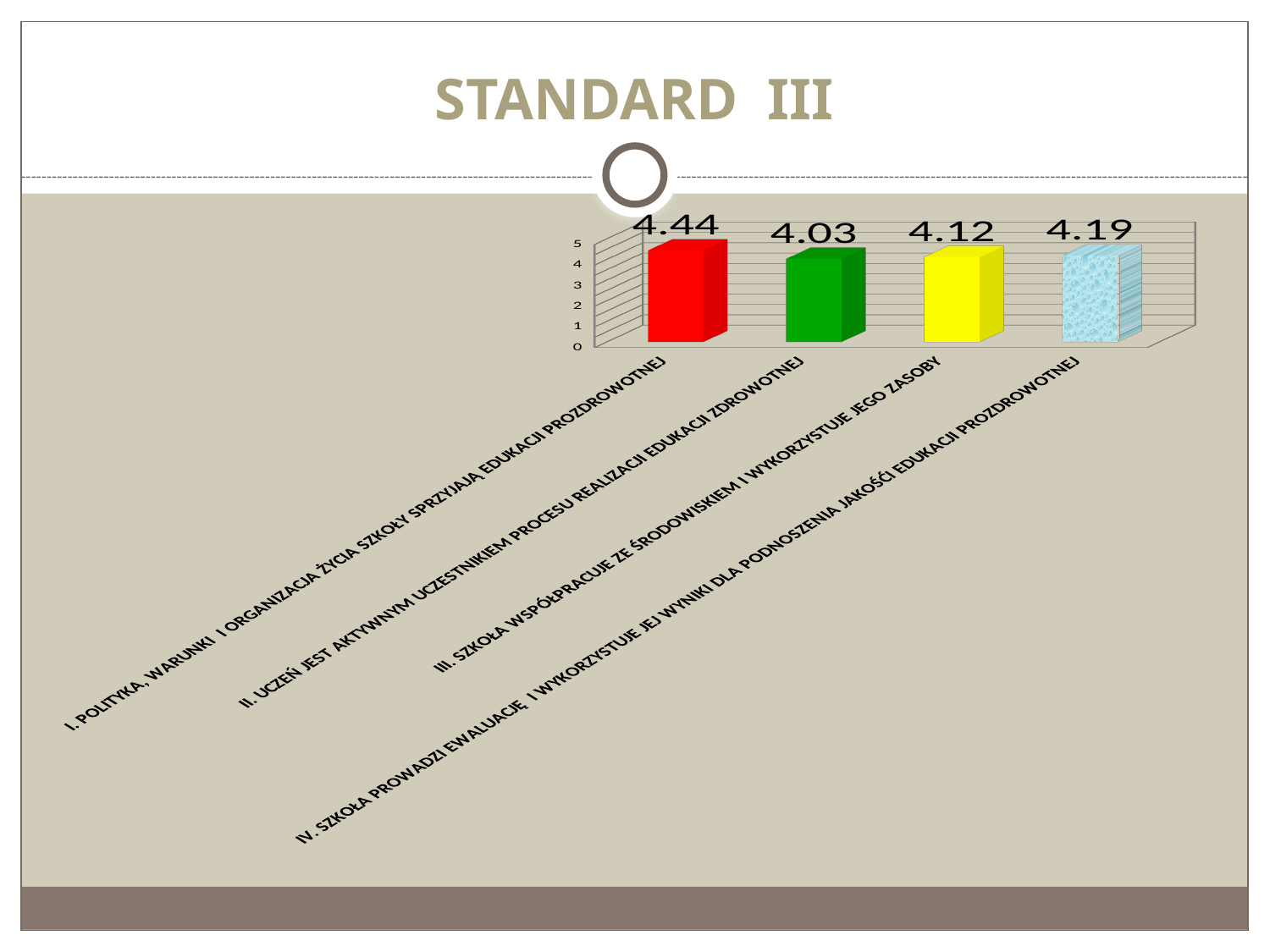
What is the value for category III (SZKOŁA WSPÓŁPRACUJE ZE ŚRODOWISKIEM I WYKORZYSTUJE JEGO ZASOBY)? 4.12 How many categories are shown in the chart? 4 What kind of chart is shown on the slide? bar chart What is the difference between the values for category IV and category III? 0.07 What is the difference between the values for category I and category II? 0.41 What is the value for category I (POLITYKA, WARUNKI I ORGANIZACJA ŻYCIA SZKOŁY SPRZYJAJĄ EDUKACJI PROZDROWOTNEJ)? 4.44 Which is larger, the value for category III or the value for category IV? category IV What is the value for category IV (SZKOŁA PROWADZI EWALUACJĘ I WYKORZYSTUJE JEJ WYNIKI DLA PODNOSZENIA JAKOŚCI EDUKACJI PROZDROWOTNEJ)? 4.19 Which category has the highest value? I. POLITYKA, WARUNKI I ORGANIZACJA ŻYCIA SZKOŁY SPRZYJAJĄ EDUKACJI PROZDROWOTNEJ What is the value for category II (UCZEŃ JEST AKTYWNYM UCZESTNIKIEM PROCESU REALIZACJI EDUKACJI ZDROWOTNEJ)? 4.03 What colour is the bar for category I? red Which category has the lowest value? II. UCZEŃ JEST AKTYWNYM UCZESTNIKIEM PROCESU REALIZACJI EDUKACJI ZDROWOTNEJ